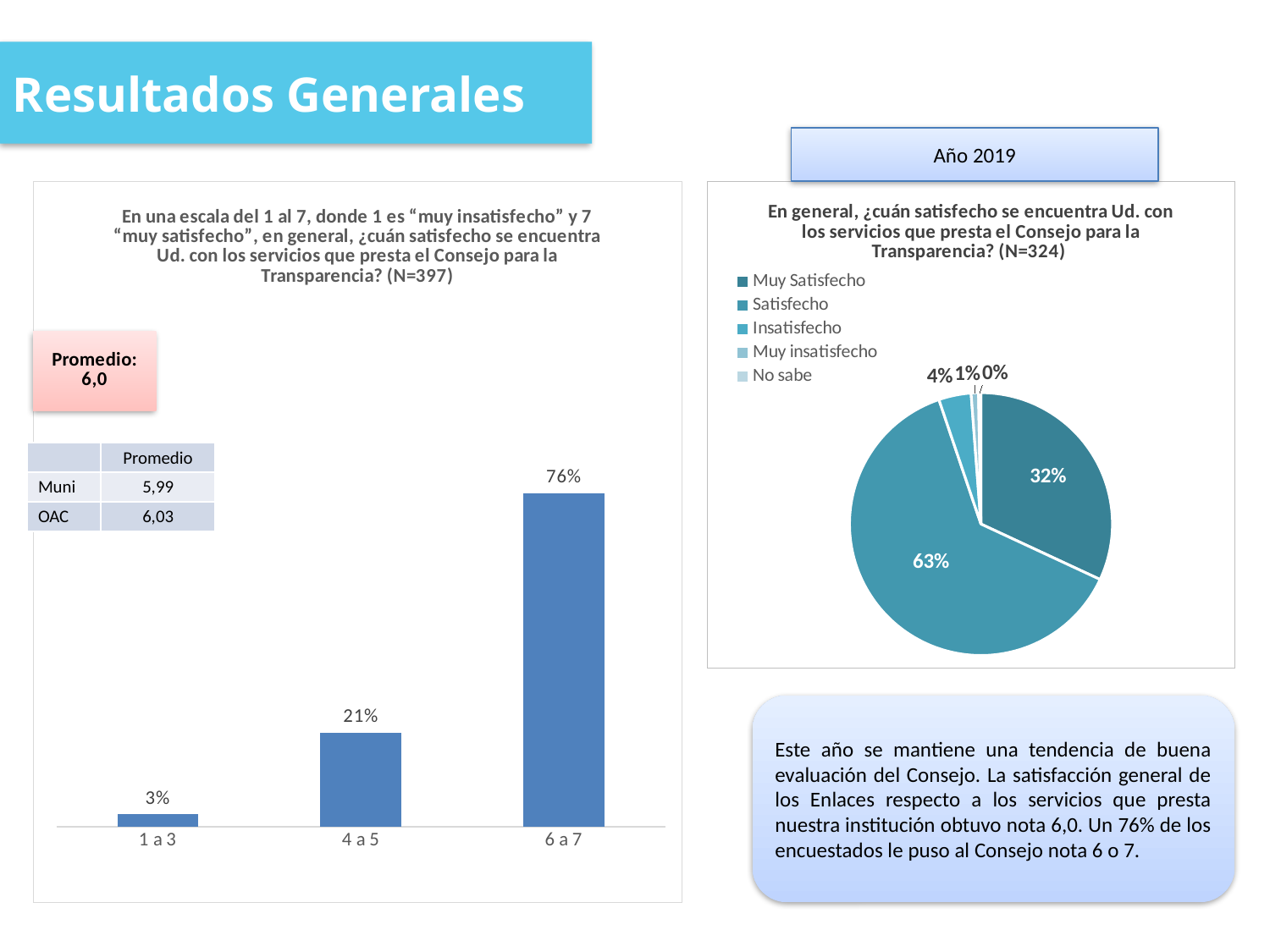
In the bar chart on the left, what is the value for the category "1 a 3"? 3% In the bar chart on the left, which category has the lowest value? 1 a 3 In the pie chart on the right, which category has the largest slice? Satisfecho In the pie chart on the right, what share corresponds to "Satisfecho"? 63% In the bar chart on the left, how many categories are shown on the x axis? 3 What kind of chart is the chart on the left side of the slide? bar chart In the pie chart on the right, which is larger: the share for "Insatisfecho" or the share for "Muy insatisfecho"? Insatisfecho In the pie chart on the right, how many categories does the legend list? 5 In the pie chart on the right, what share corresponds to "Muy Satisfecho"? 32% In the bar chart on the left, what is the difference between the values for "6 a 7" and "4 a 5"? 55% In the bar chart on the left, do the values rise or fall from "1 a 3" to "6 a 7"? rise In the bar chart on the left, what is the value for the category "6 a 7"? 76%